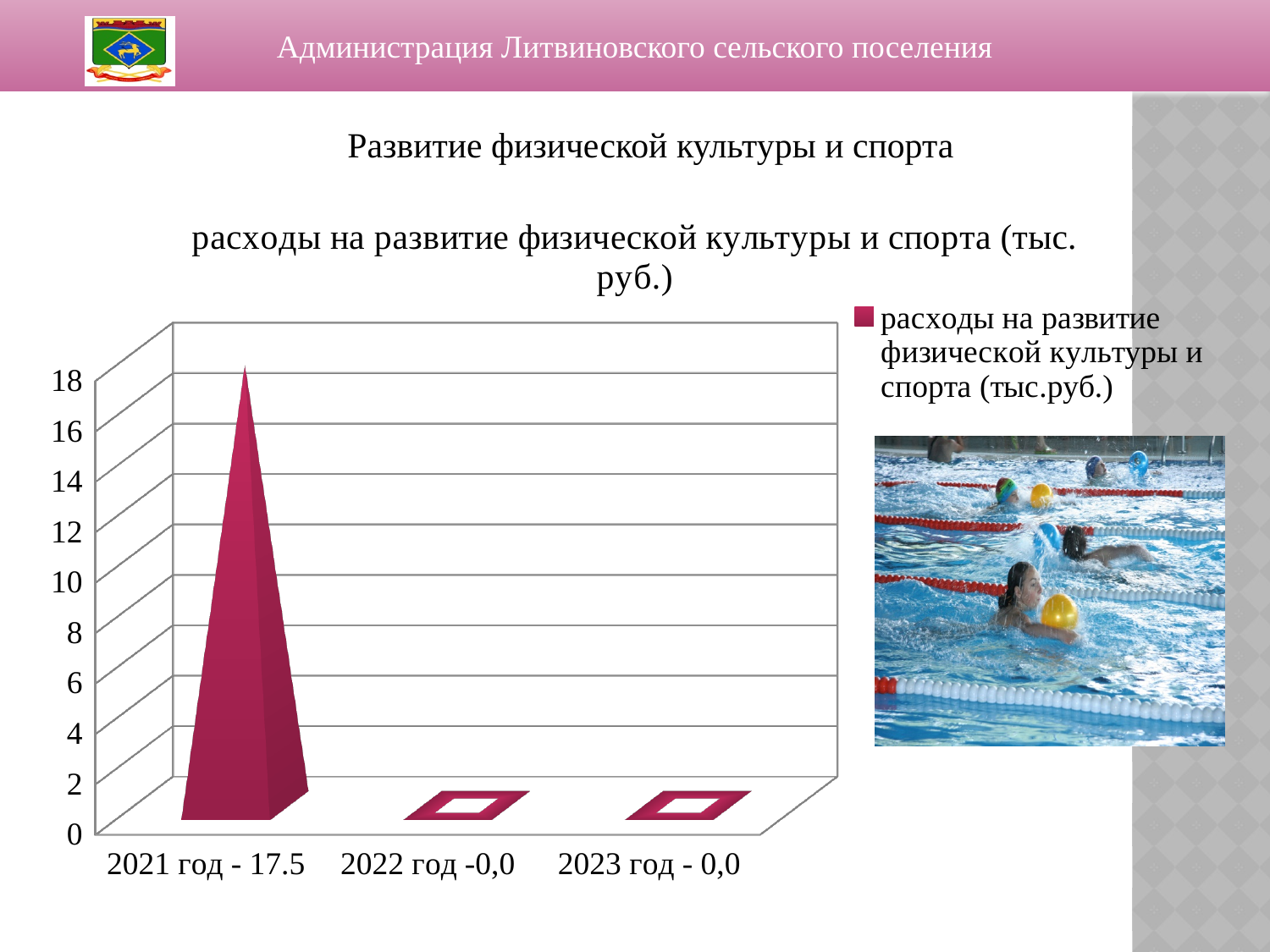
What is the value for 2022 год according to the category label? 0,0 What is the title of the chart? расходы на развитие физической культуры и спорта (тыс. руб.) What is the difference between the value for 2021 год and the value for 2023 год? 17.5 What type of chart is shown on the slide? bar chart How many categories are shown on the x axis of the chart? 3 Do the values rise or fall from 2021 год to 2023 год? fall Is the value for 2021 год greater or less than 16? greater What is the value for 2023 год according to the category label? 0,0 What is the value for 2021 год according to the category label? 17.5 Which year has the highest value in the chart? 2021 год Which is larger, the value for 2021 год or the value for 2022 год? 2021 год How many series does the chart legend list? 1